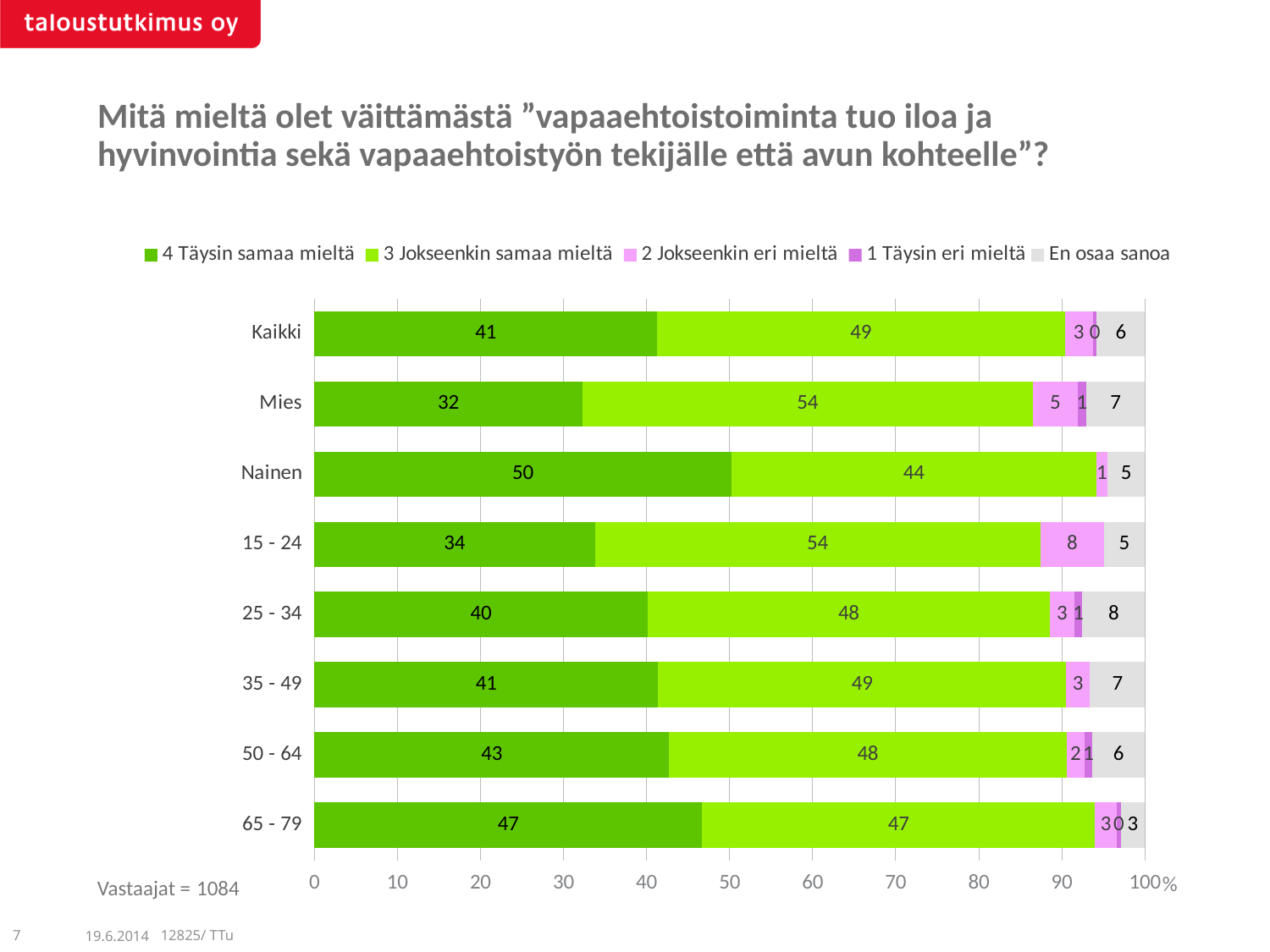
What is the value for "En osaa sanoa" in the 65 - 79 bar? 3 Which category has the lowest value for "4 Täysin samaa mieltä"? Mies What kind of chart is shown on the slide? Stacked bar chart What is the value for "4 Täysin samaa mieltä" in the Kaikki bar? 41 How many categories (bars) are shown in the chart? 8 What is the value for "2 Jokseenkin eri mieltä" in the 15 - 24 bar? 8 Which category has the highest value for "4 Täysin samaa mieltä"? Nainen How many series does the legend list? 5 What is the value for "3 Jokseenkin samaa mieltä" in the Mies bar? 54 What is the difference between the "4 Täysin samaa mieltä" values for Nainen and Mies? 18 Which has the larger "3 Jokseenkin samaa mieltä" value, 15 - 24 or 25 - 34? 15 - 24 Which category has the highest value for "En osaa sanoa"? 25 - 34